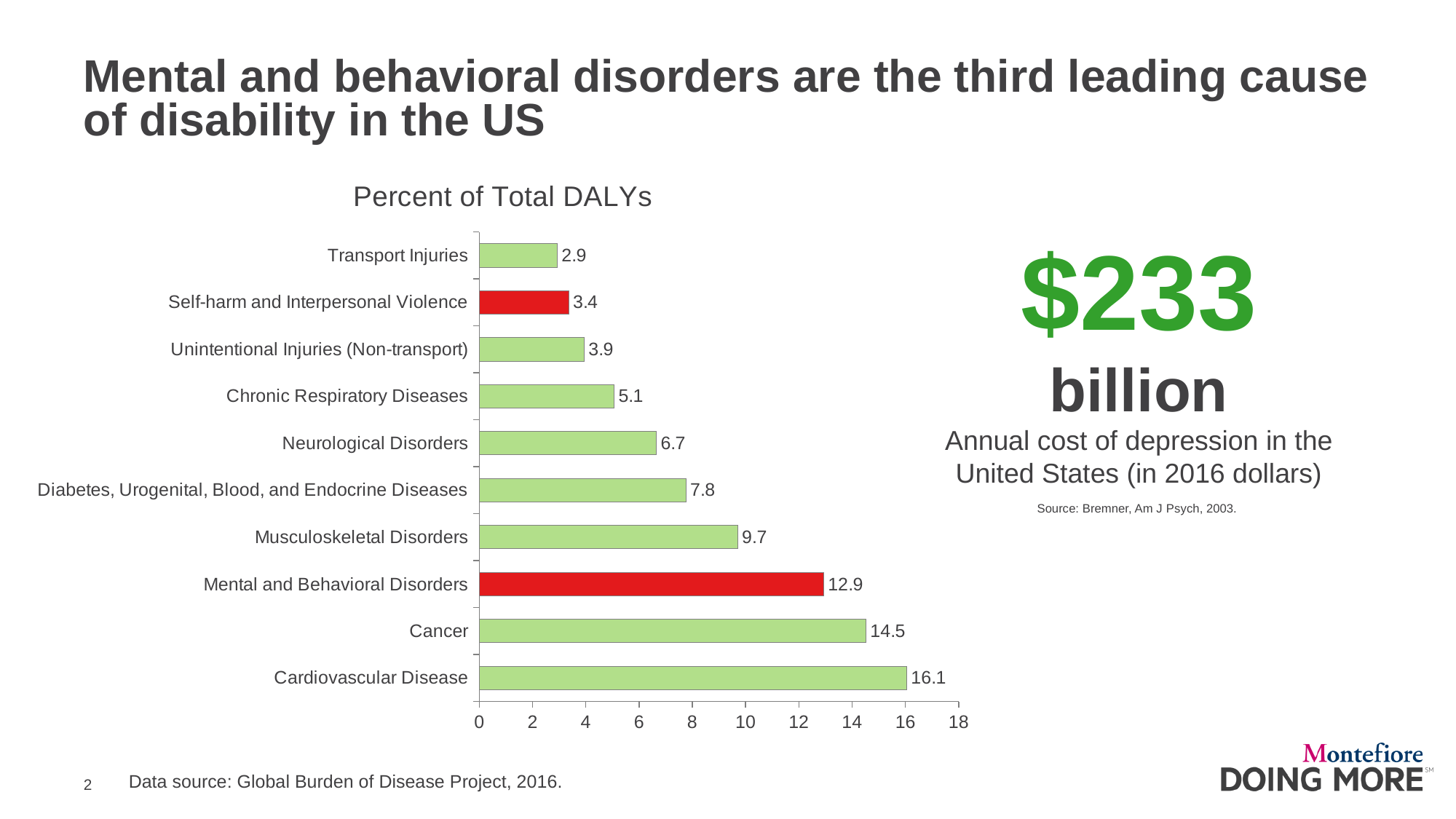
What is the value for Cancer? 14.5 How many categories are shown in the chart? 10 What is the difference between the values for Cardiovascular Disease and Mental and Behavioral Disorders? 3.2 Which two bars in the chart are colored red? Self-harm and Interpersonal Violence and Mental and Behavioral Disorders Which category has the lowest percent of total DALYs? Transport Injuries Is the value for Chronic Respiratory Diseases greater or less than 6? less Which category has the highest percent of total DALYs? Cardiovascular Disease What is the title of the chart? Percent of Total DALYs What is the value for Self-harm and Interpersonal Violence? 3.4 What is the value for Mental and Behavioral Disorders? 12.9 Which is larger, the value for Musculoskeletal Disorders or the value for Neurological Disorders? Musculoskeletal Disorders What kind of chart is shown on the slide? bar chart